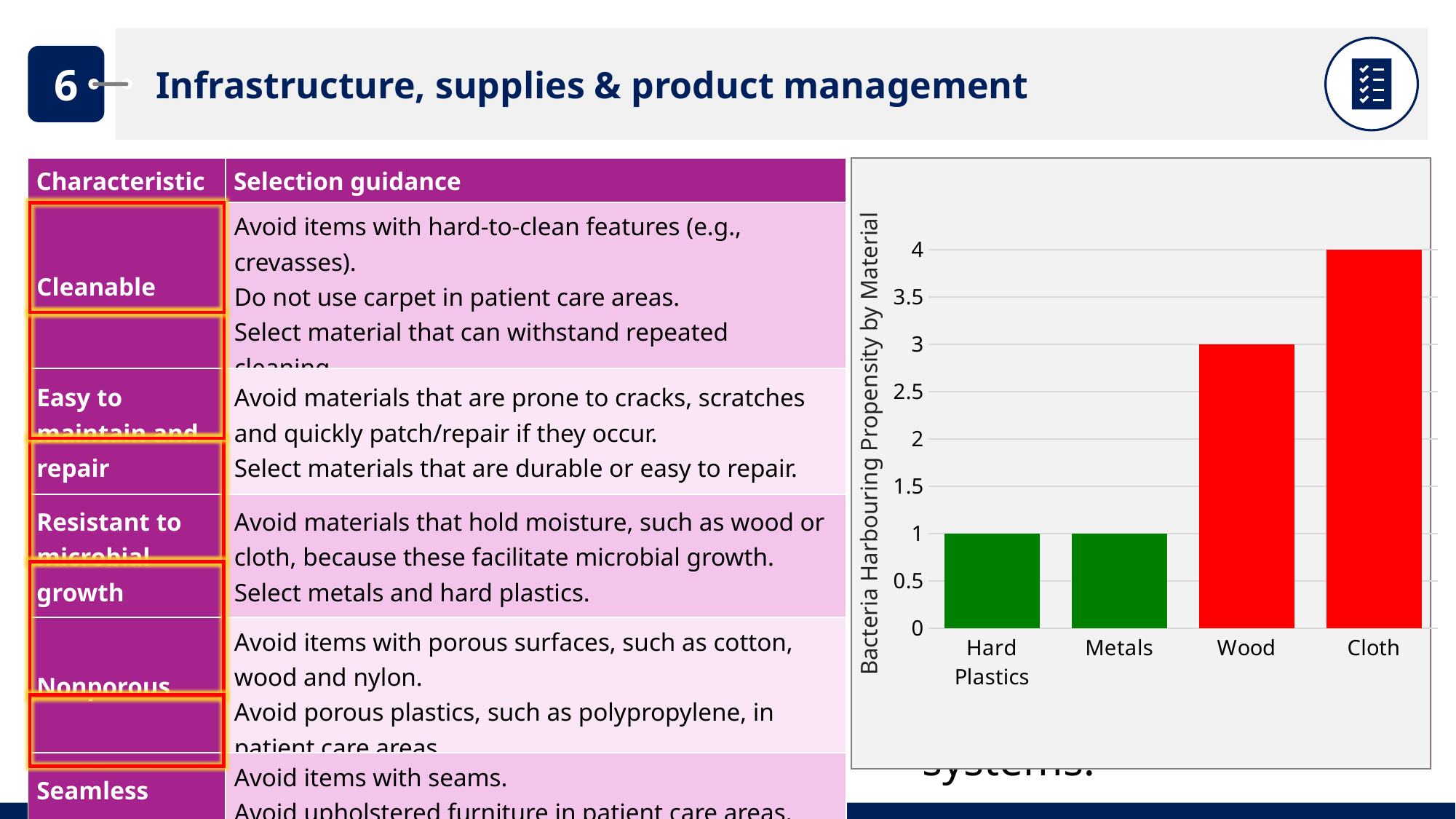
What is the bacteria harbouring propensity value for Wood? 3 What is the difference between the values for Cloth and Wood? 1 What kind of chart is shown on the slide? bar chart Which has a larger value, Wood or Hard Plastics? Wood What is the bacteria harbouring propensity value for Hard Plastics? 1 What is the difference between the values for Wood and Metals? 2 How many materials are plotted on the chart? 4 What is the bacteria harbouring propensity value for Cloth? 4 Which material has the highest bacteria harbouring propensity on the chart? Cloth Is the value for Cloth greater or less than 3.5? greater What is the label on the vertical axis of the chart? Bacteria Harbouring Propensity by Material What is the bacteria harbouring propensity value for Metals? 1